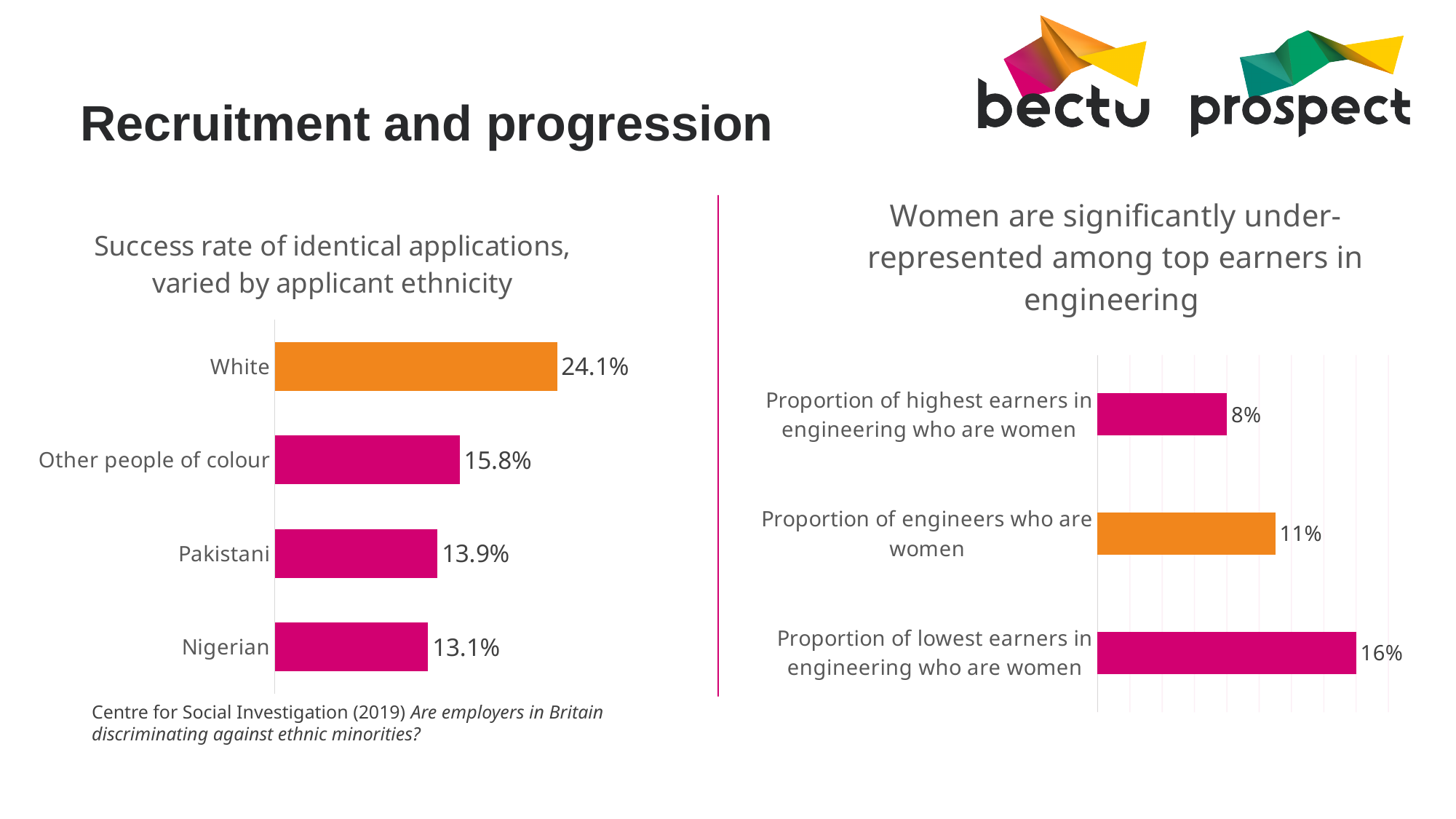
In the left chart (Success rate of identical applications), what is the difference between the success rates for White and Pakistani applicants? 10.2% What type of chart is the right chart (Women among top earners in engineering)? Bar chart In the right chart (Women among top earners in engineering), what is the proportion of engineers who are women? 11% In the right chart (Women among top earners in engineering), what is the difference between the proportion of lowest earners who are women and the proportion of highest earners who are women? 8% In the left chart (Success rate of identical applications), what is the success rate for Nigerian applicants? 13.1% In the right chart (Women among top earners in engineering), which category has the largest value? Proportion of lowest earners in engineering who are women In the left chart (Success rate of identical applications), which applicant group has the highest success rate? White In the left chart (Success rate of identical applications), how many applicant groups are shown? 4 In the left chart (Success rate of identical applications), what is the success rate for White applicants? 24.1% In the left chart (Success rate of identical applications), which applicant group has the lowest success rate? Nigerian In the left chart (Success rate of identical applications), which bar is coloured orange rather than pink? White In the right chart (Women among top earners in engineering), what is the proportion of highest earners in engineering who are women? 8%